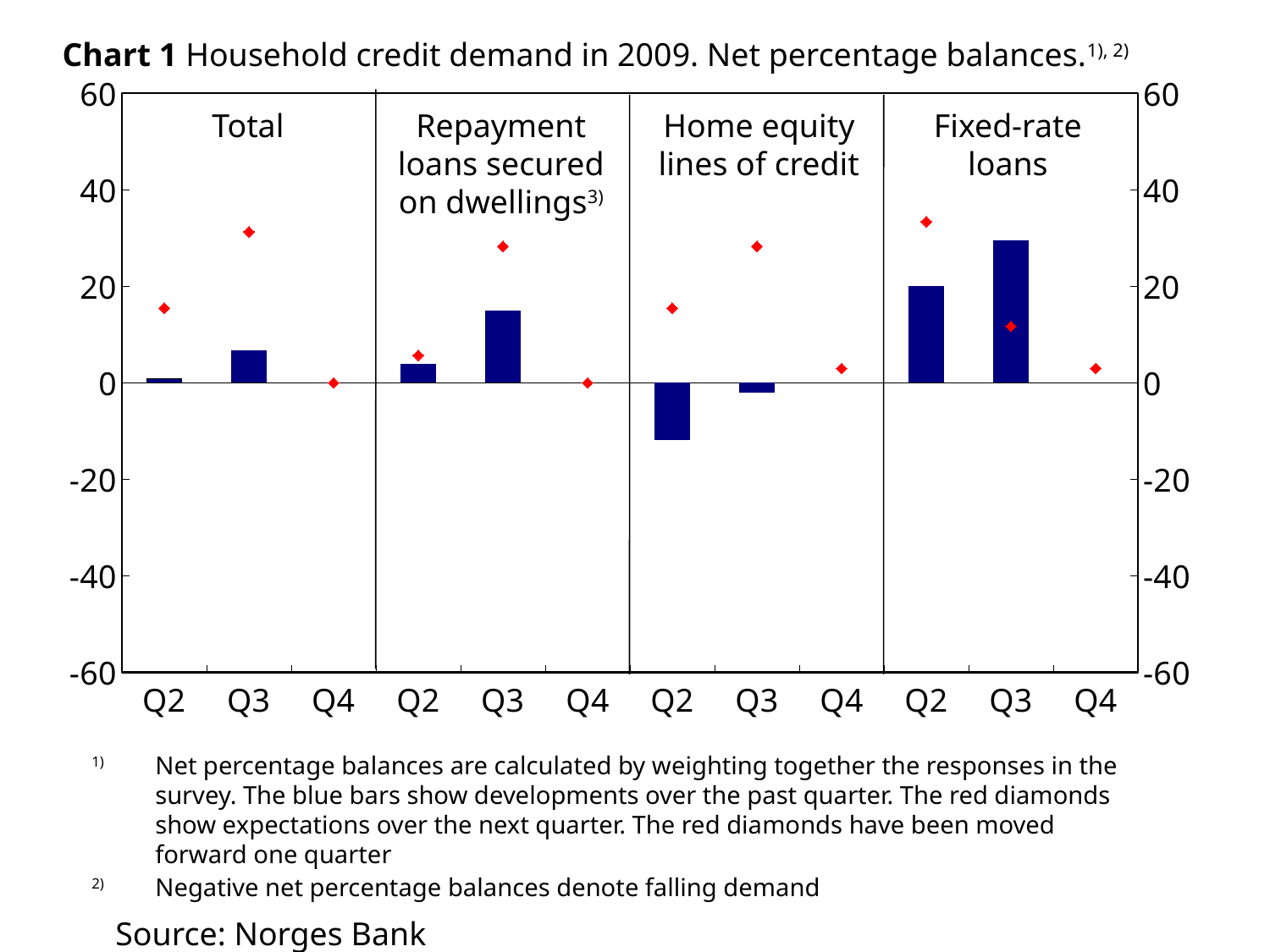
Is the Q3 bar for Fixed-rate loans greater or less than 20? greater How many quarters are labelled on the x axis within each panel of Chart 1? 3 For Fixed-rate loans, which is larger: the Q2 bar or the Q3 bar? Q3 bar Do the blue bars for Total rise or fall from Q2 to Q3? rise Which category has the highest Q3 bar in Chart 1? Fixed-rate loans Is the Q3 red diamond for Total greater or less than 20? greater Is the Q2 bar for Home equity lines of credit greater or less than 0? less According to the footnote, what do the red diamonds in Chart 1 show? Expectations over the next quarter Which category has the lowest Q2 bar in Chart 1? Home equity lines of credit What kind of chart is Chart 1? combination chart: bar chart with red diamond markers For Fixed-rate loans in Q3, which is larger: the blue bar or the red diamond? the blue bar How many loan categories (panels) are shown in Chart 1? 4